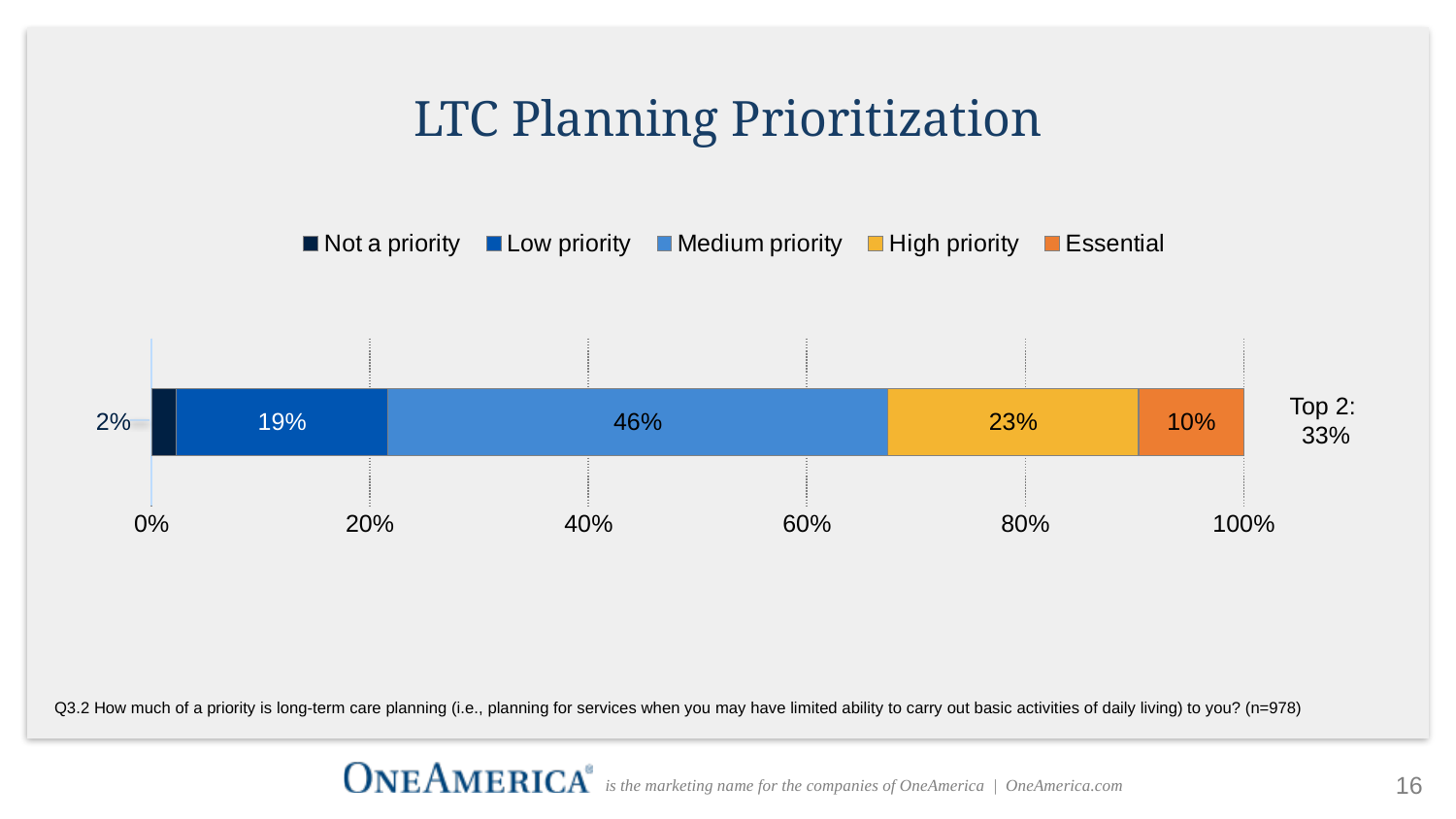
What is the title of the chart? LTC Planning Prioritization What percentage of respondents said LTC planning is a medium priority? 46% Which priority level has the smallest share of respondents? Not a priority What percentage of respondents said LTC planning is essential? 10% How many series does the legend list? 5 Which priority level has the largest share of respondents? Medium priority What kind of chart is shown on the slide? Stacked bar chart Which is larger, the share for Low priority or the share for Essential? Low priority What is the difference in percentage points between Medium priority and High priority? 23 What is the Top 2 percentage shown next to the bar? 33% What percentage of respondents said LTC planning is a high priority? 23% What percentage of respondents said LTC planning is not a priority? 2%